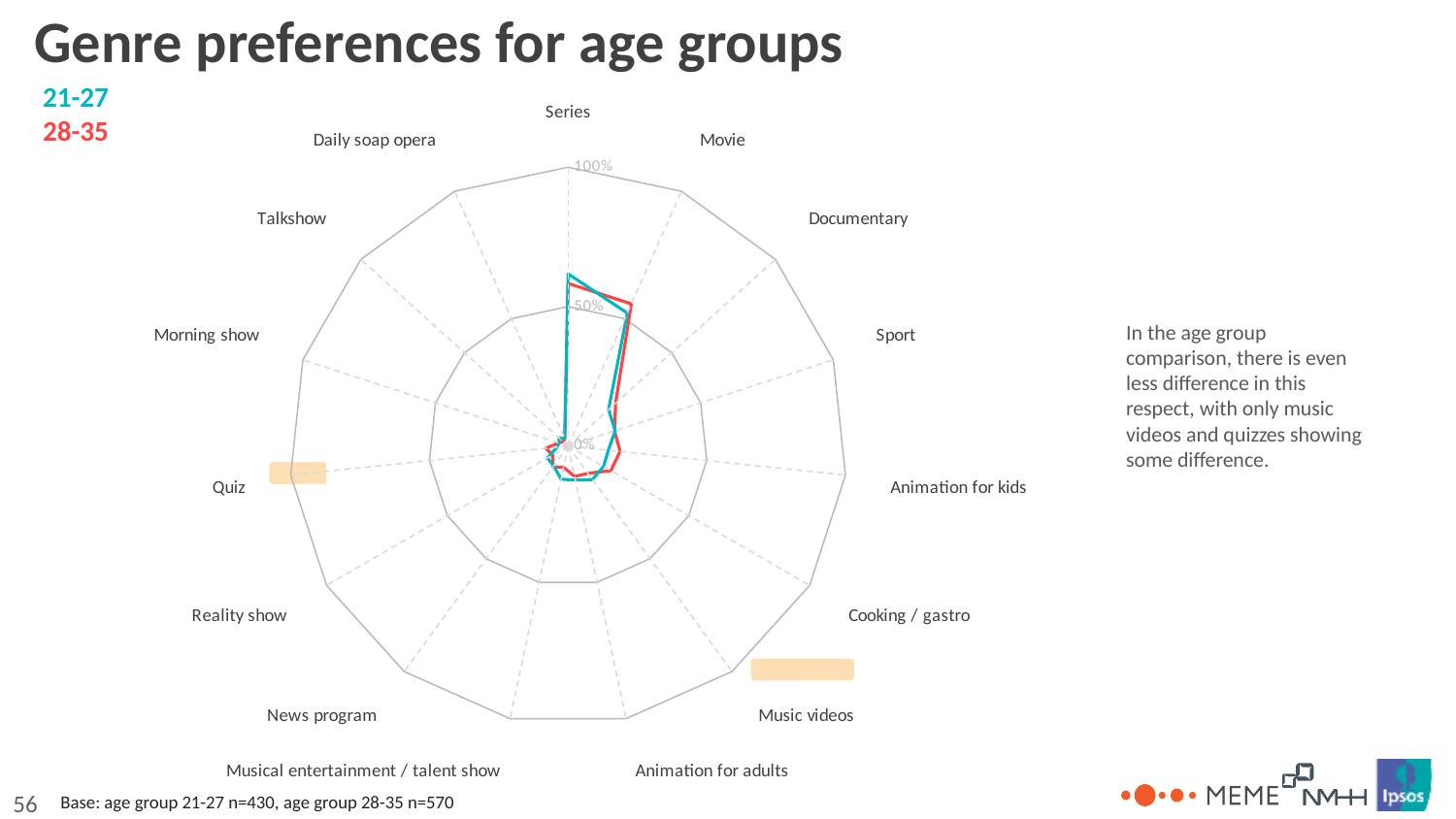
Which genre has the highest value for the 21-27 age group? Series For the 28-35 age group, which is larger: Documentary or Animation for kids? Documentary For the 21-27 age group, which is larger: Series or Quiz? Series Which colour represents the 28-35 age group in the chart? Red What is the title of the chart? Genre preferences for age groups Is the value for Series in the 21-27 age group greater or less than 50%? greater What kind of chart is shown on the slide? Radar chart How many genre categories are plotted on the radar chart? 15 Is the value for Reality show in the 21-27 age group greater or less than 50%? less How many series does the legend list? 2 Is the value for Sport in the 28-35 age group greater or less than 50%? less